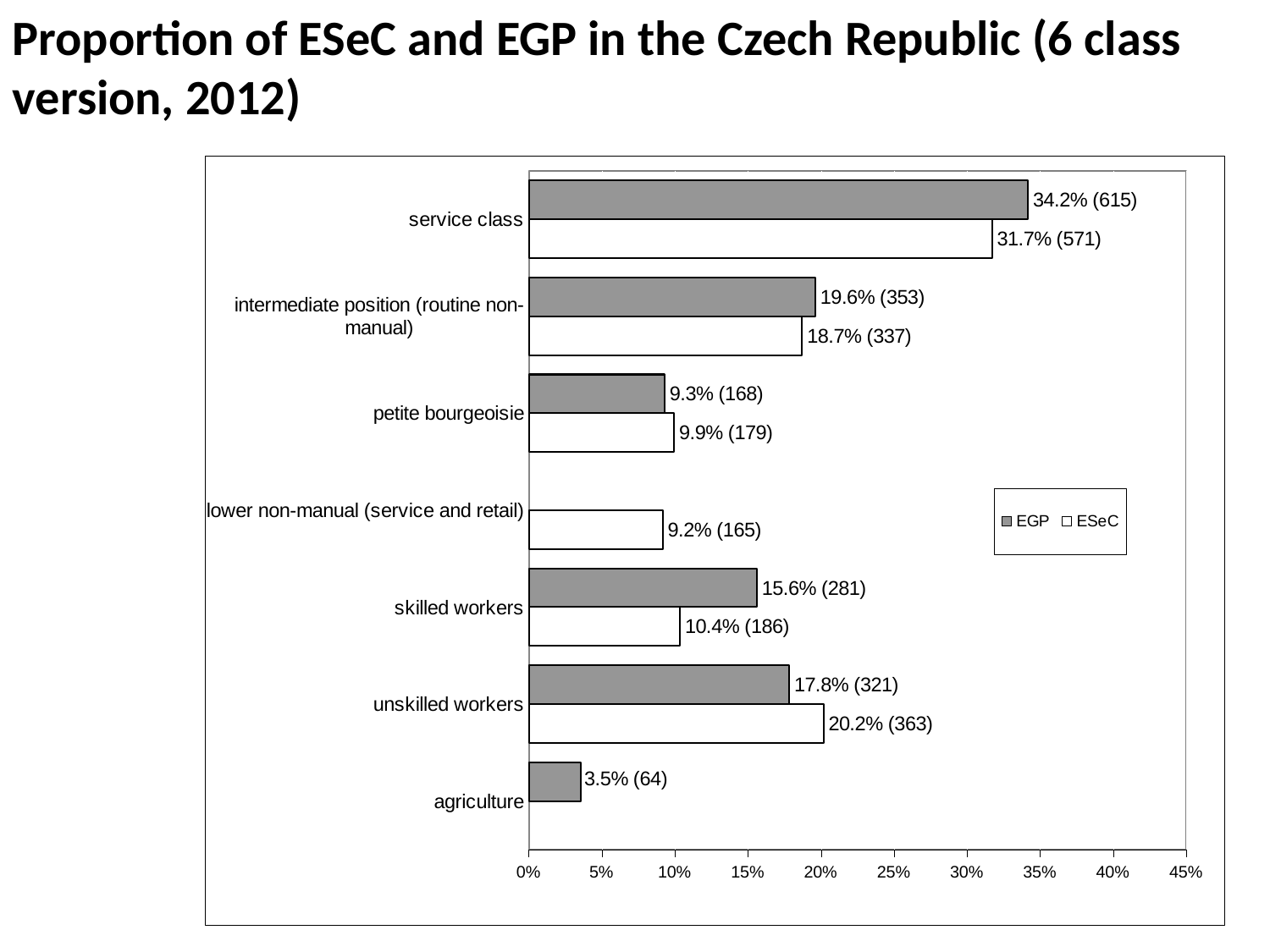
What kind of chart is shown on the slide? bar chart Which is larger for unskilled workers, the EGP value or the ESeC value? ESeC Which category has the lowest EGP value? agriculture How many series does the legend list? 2 How many categories are shown on the chart? 7 Which series is shown with grey bars? EGP What is the ESeC value for unskilled workers? 20.2% (363) What is the ESeC value for lower non-manual (service and retail)? 9.2% (165) Which is larger for petite bourgeoisie, the EGP value or the ESeC value? ESeC Which category has the highest EGP value? service class What is the EGP value for service class? 34.2% (615) What is the difference in percentage points between the EGP and ESeC values for skilled workers? 5.2